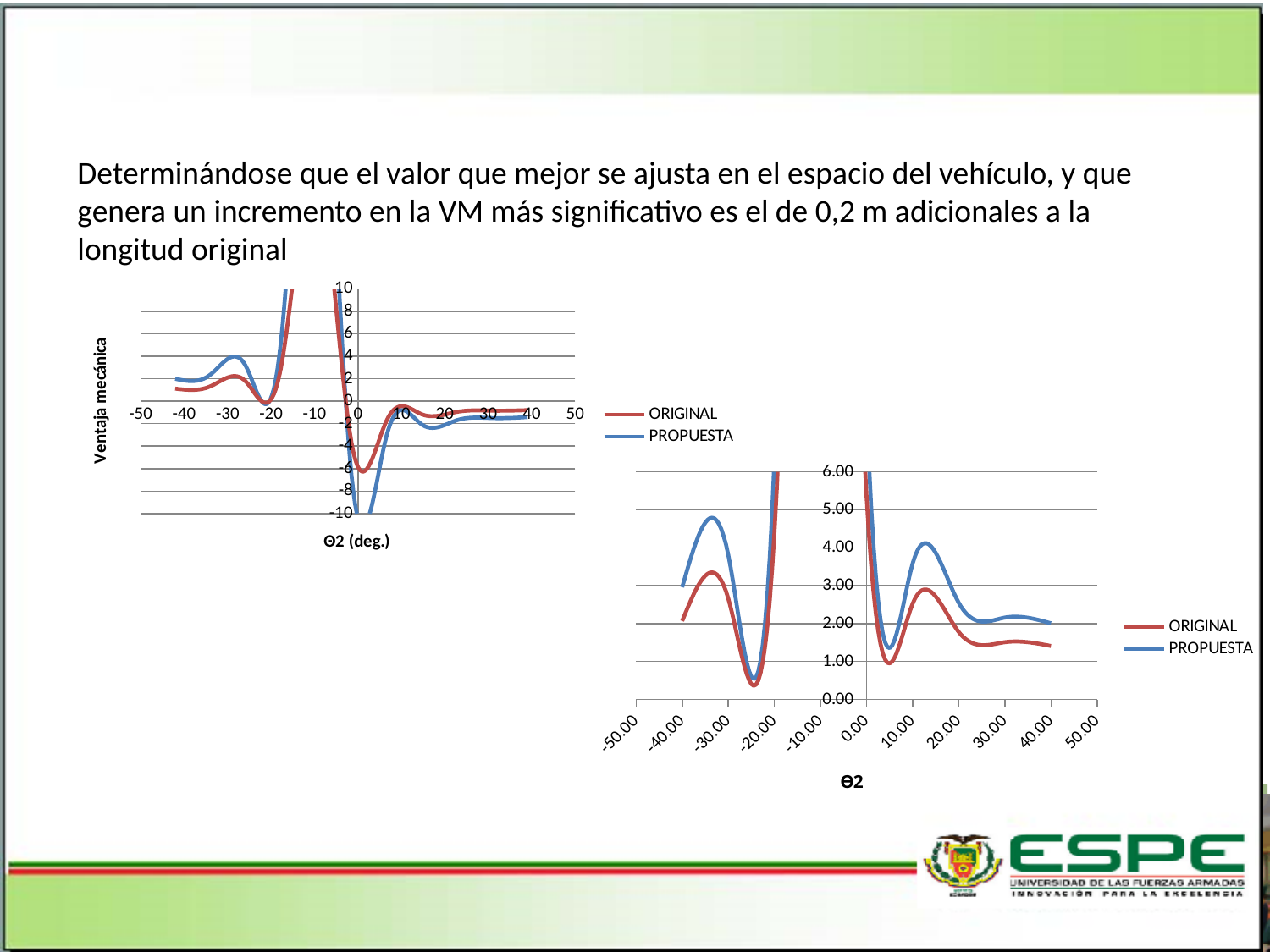
What is the y-axis title of the chart on the left? Ventaja mecánica In the chart on the right, is the minimum of the ORIGINAL series near Θ2 = 5.00 greater or less than 2.00? less What kind of chart is the chart on the left of the slide? line chart In the chart on the right, is the peak value of the PROPUESTA series between Θ2 = 10.00 and 20.00 greater or less than 3.00? greater How many series does the legend of the chart on the right list? 2 In the chart on the right, is the peak value of the PROPUESTA series near Θ2 = -30.00 greater or less than 4.00? greater In the chart on the right, which series has the higher value at Θ2 = 40.00, ORIGINAL or PROPUESTA? PROPUESTA What are the two series named in the legend of the chart on the left? ORIGINAL and PROPUESTA In the chart on the right, which series reaches the higher peak between Θ2 = 10.00 and 20.00, ORIGINAL or PROPUESTA? PROPUESTA